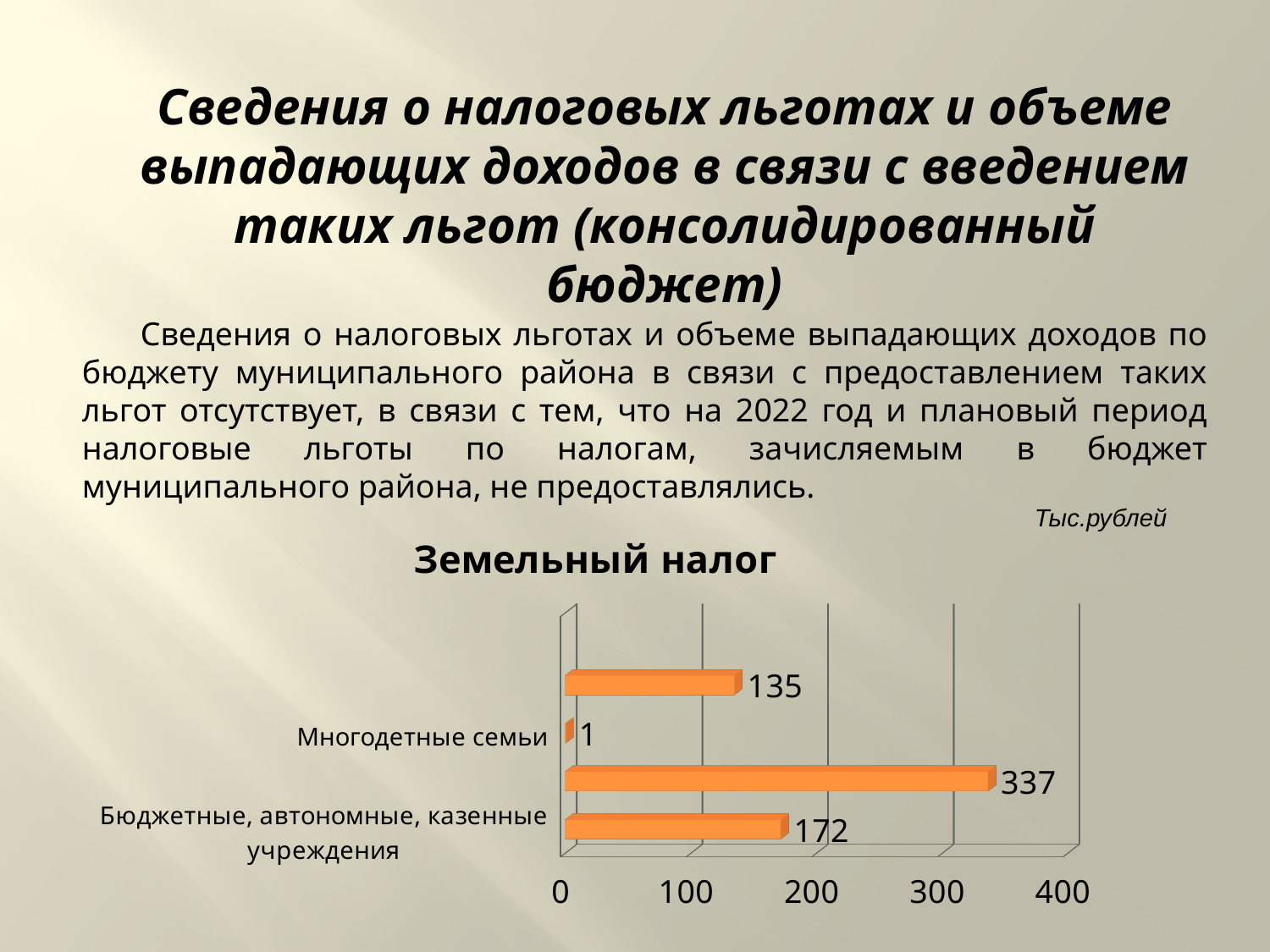
What is the title of the chart on the slide? Земельный налог Is the value for Бюджетные, автономные, казенные учреждения in the Земельный налог chart greater or less than 200? less Is the largest bar in the Земельный налог chart greater or less than 300? greater What kind of chart is the Земельный налог chart? bar chart How many bars are plotted in the Земельный налог chart? 4 What is the value for Многодетные семьи in the Земельный налог chart? 1 What unit is indicated above the chart on the slide? Тыс.рублей What is the largest value shown on any bar in the Земельный налог chart? 337 What is the value for Бюджетные, автономные, казенные учреждения in the Земельный налог chart? 172 Which labelled category has the lowest value in the Земельный налог chart? Многодетные семьи What is the difference between the values for Бюджетные, автономные, казенные учреждения and Многодетные семьи in the Земельный налог chart? 171 Which is larger in the Земельный налог chart: the value for Бюджетные, автономные, казенные учреждения or the value for Многодетные семьи? Бюджетные, автономные, казенные учреждения